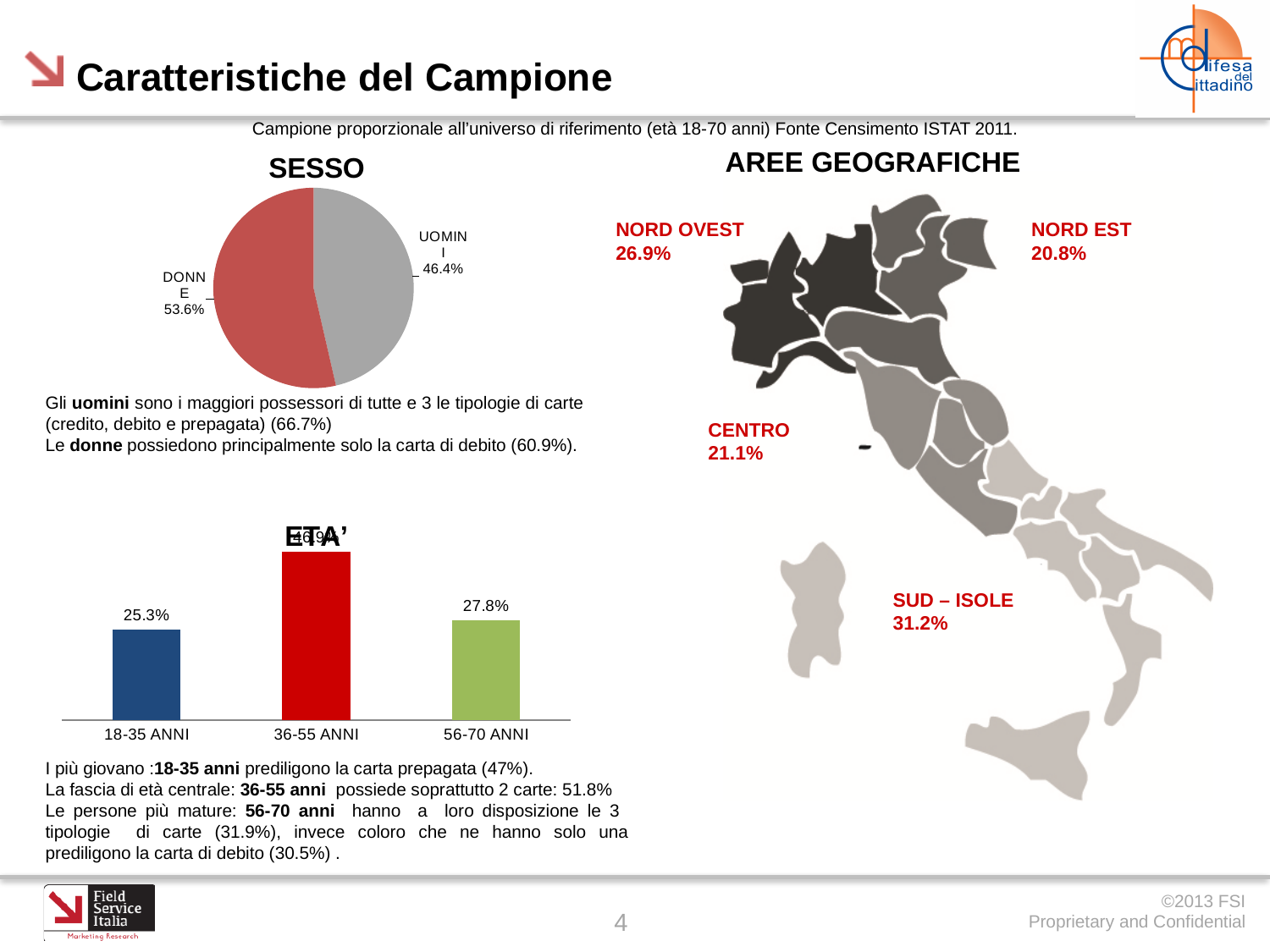
How many slices does the SESSO pie chart have? 2 How many age groups are shown in the ETA' bar chart? 3 In the ETA' bar chart, what is the value for 56-70 ANNI? 27.8% In the ETA' bar chart, what is the difference in percentage points between 56-70 ANNI and 18-35 ANNI? 2.5 percentage points In the ETA' bar chart, which age group has the lowest bar? 18-35 ANNI In the SESSO pie chart, what is the difference in percentage points between DONNE and UOMINI? 7.2 percentage points In the SESSO pie chart, which slice is larger, DONNE or UOMINI? DONNE What kind of chart is the SESSO chart? Pie chart In the SESSO pie chart, what percentage is shown for UOMINI? 46.4% In the SESSO pie chart, what percentage is shown for DONNE? 53.6% In the ETA' bar chart, what is the value for 18-35 ANNI? 25.3% In the ETA' bar chart, which age group has the highest bar? 36-55 ANNI